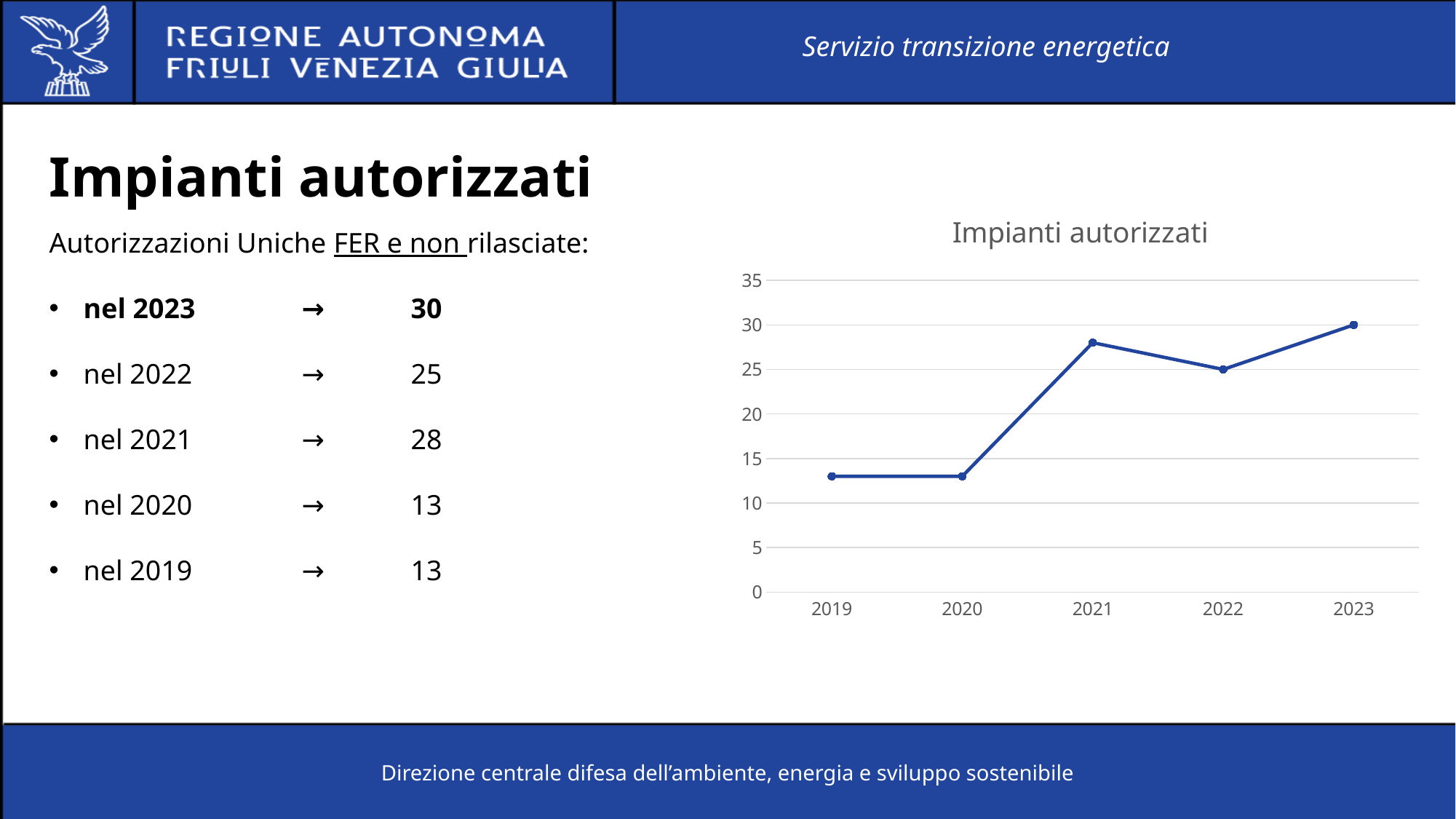
Which year has the highest value in the chart? 2023 What kind of chart is shown on the slide? line chart Which is larger, the value for 2021 or the value for 2022? 2021 What is the value for 2019 in the chart? 13 Is the value for 2021 greater or less than 25? greater What is the difference between the values for 2023 and 2022? 5 What is the value for 2022 in the chart? 25 What is the title of the chart? Impianti autorizzati What is the value for 2021 in the chart? 28 How many years are plotted on the x axis of the chart? 5 What is the value for 2023 in the chart? 30 Is the value for 2020 greater or less than 15? less